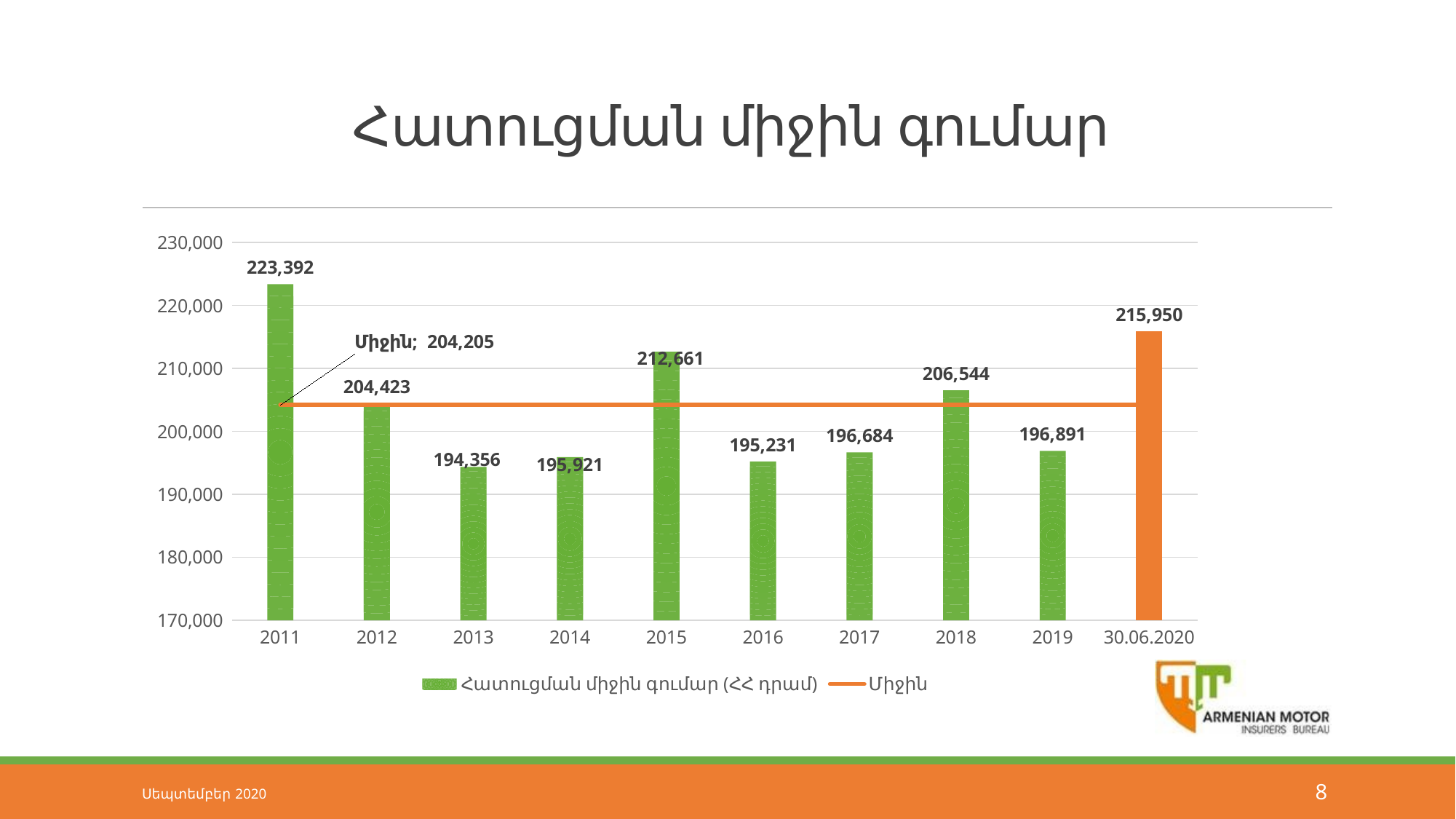
What is the difference between the values for 2011 and 2012? 18,969 Is the value for 2016 greater or less than 200,000? less What is the value for 2015? 212,661 Which is larger, the value for 2018 or the value for 2019? 2018 How many categories are shown on the x axis? 10 What is the value for 2011? 223,392 Which category has the lowest value? 2013 What value is shown for the average (Միջին) line? 204,205 What kind of chart is shown on the slide? combination bar and line chart What is the value for 30.06.2020? 215,950 How many series does the legend list? 2 Which category has the highest value? 2011